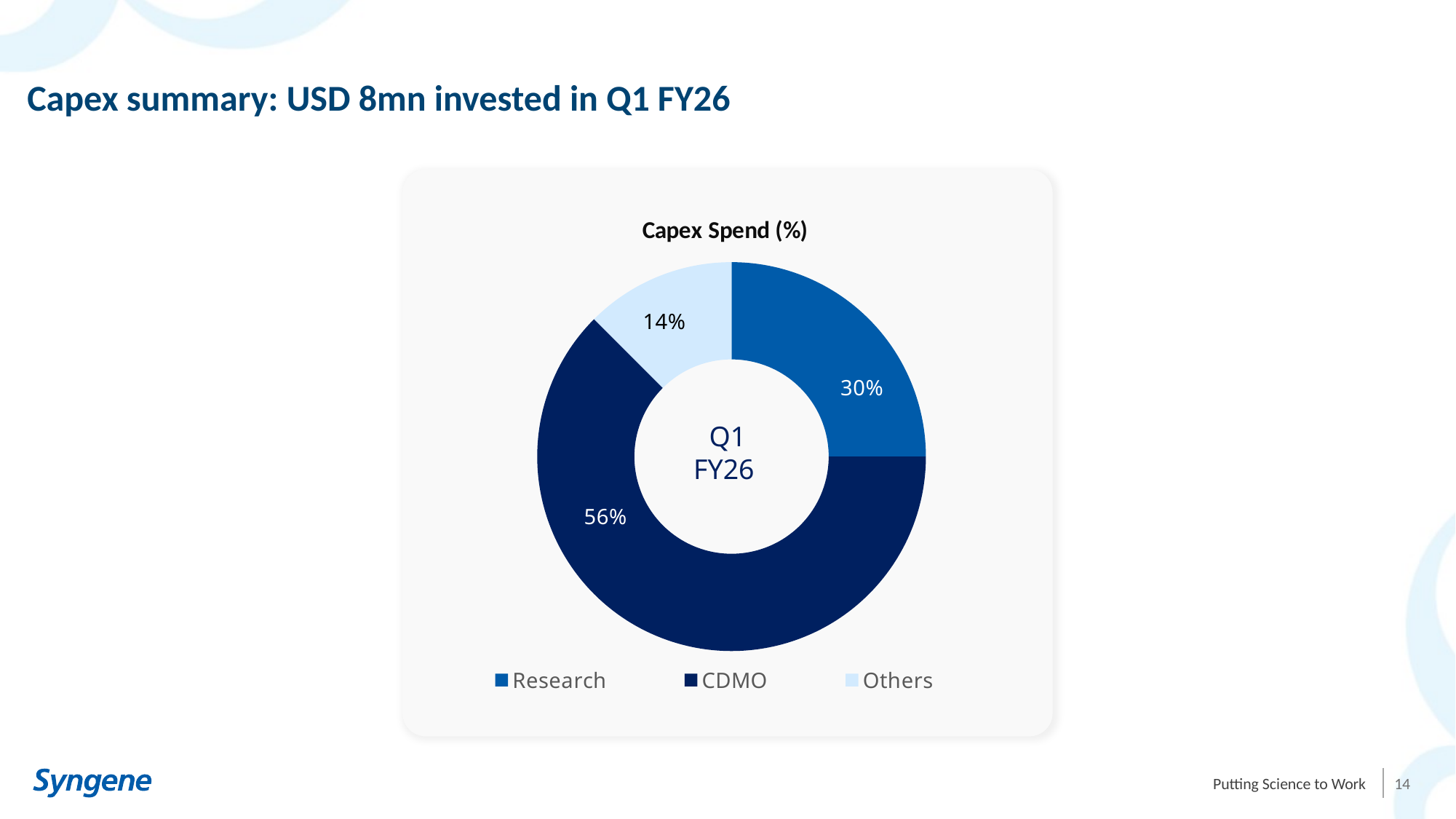
How many entries does the legend list? 3 How many categories are shown in the chart? 3 What is the difference in percentage points between the Research and Others shares? 16 Which category has the smallest share of capex spend? Others What kind of chart is shown on the slide? Pie chart (donut) Which category has the largest share of capex spend? CDMO What share of capex spend does Others account for? 14% What is the difference in percentage points between the CDMO and Research shares? 26 Which has a larger share of capex spend, Research or Others? Research What share of capex spend does Research account for? 30% What is the title of the chart? Capex Spend (%) What share of capex spend does CDMO account for? 56%